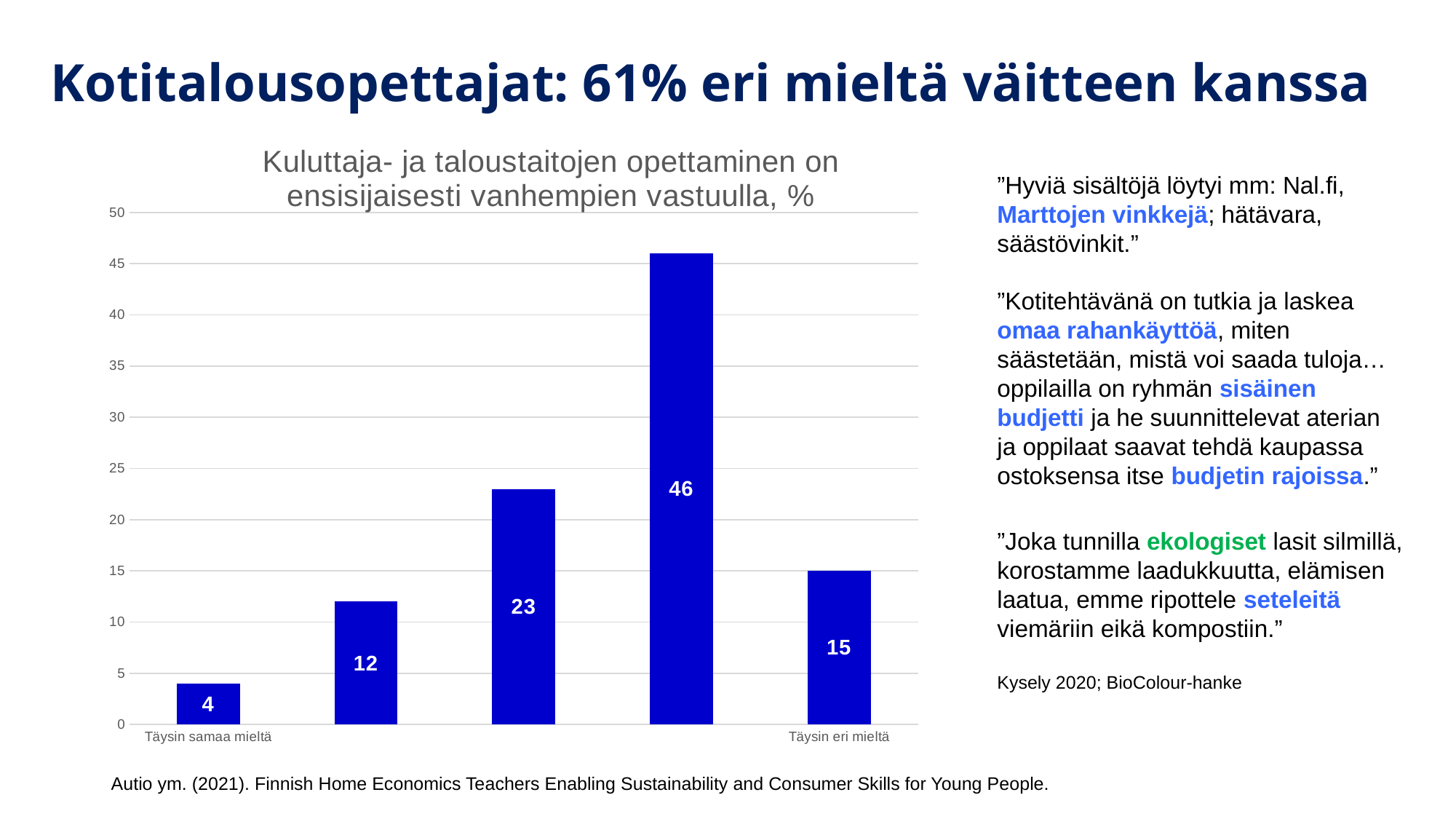
What is the difference between the values for "Täysin eri mieltä" and "Täysin samaa mieltä"? 11 Which category has the lowest value? Täysin samaa mieltä What is the value for "Täysin eri mieltä"? 15 How many bars are shown in the chart? 5 What is the value for "Täysin samaa mieltä"? 4 What is the value of the middle (third) bar? 23 What is the highest value shown in the chart? 46 Which is larger, the value for "Täysin samaa mieltä" or for "Täysin eri mieltä"? Täysin eri mieltä What kind of chart is shown on the slide? bar chart Is the value of the second bar from the left greater or less than 10? greater What is the title of the chart? Kuluttaja- ja taloustaitojen opettaminen on ensisijaisesti vanhempien vastuulla, % What is the difference between the tallest bar and the middle bar? 23